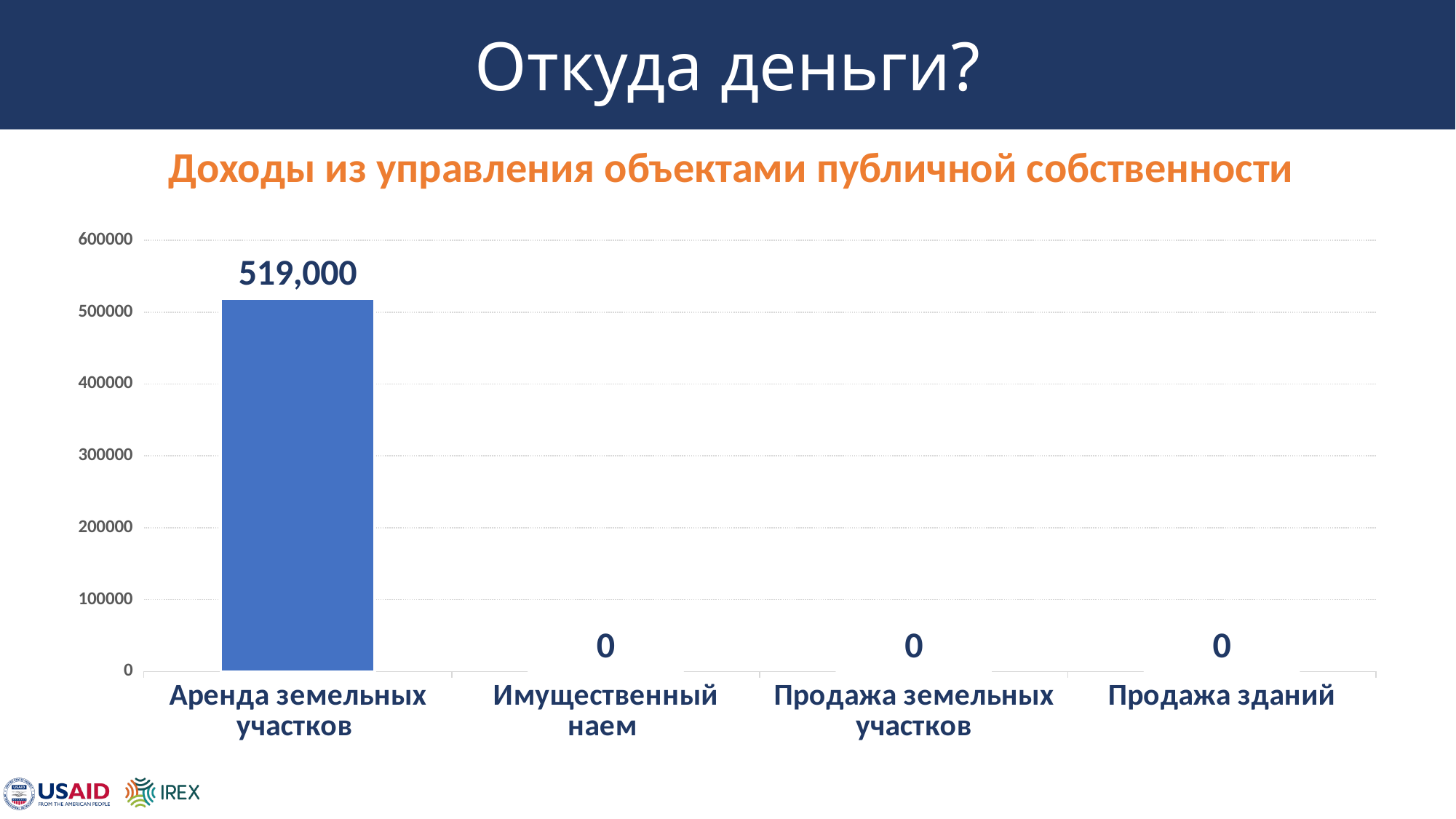
What is the title of the chart? Доходы из управления объектами публичной собственности How many categories have a value of 0? 3 What is the highest value shown on the y axis? 600000 What kind of chart is shown on the slide? bar chart What is the value for Аренда земельных участков? 519,000 Is the value for Аренда земельных участков greater or less than 500000? greater What is the value for Имущественный наем? 0 Which is larger, Аренда земельных участков or Имущественный наем? Аренда земельных участков How many categories are shown on the x axis? 4 Which category has the highest value? Аренда земельных участков What is the value for Продажа зданий? 0 What is the difference between Аренда земельных участков and Продажа земельных участков? 519,000